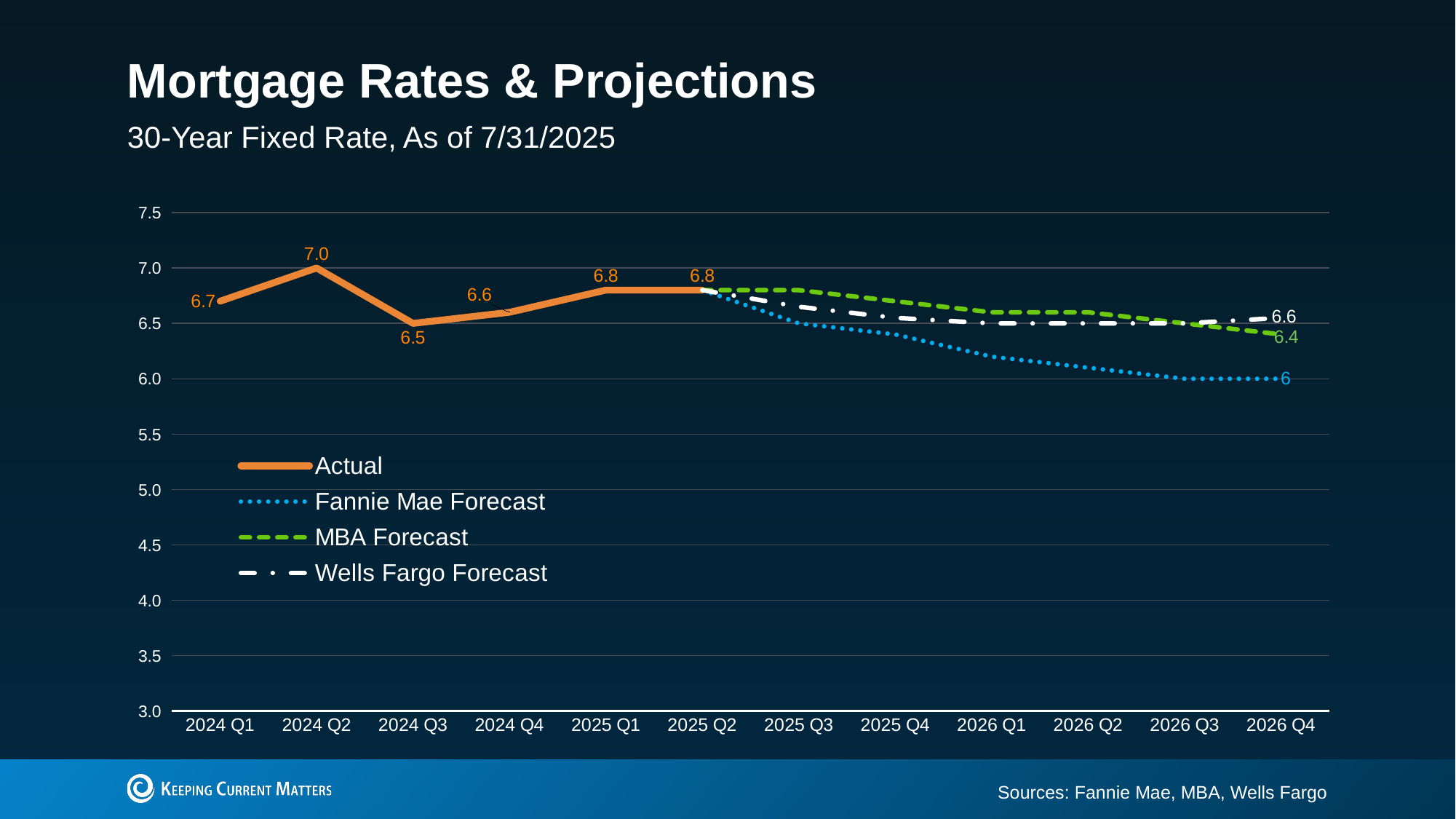
How many series does the legend list? 4 What is the MBA Forecast value for 2026 Q4? 6.4 What kind of chart is shown on the slide? line chart What is the difference between the Actual rate in 2024 Q2 and in 2024 Q3? 0.5 What is the Wells Fargo Forecast value for 2026 Q4? 6.6 How many quarters are shown on the x axis? 12 What is the Actual 30-year fixed rate for 2024 Q3? 6.5 In which quarter is the Actual rate lowest? 2024 Q3 What is the Fannie Mae Forecast value for 2026 Q4? 6 In which quarter is the Actual rate highest? 2024 Q2 What is the Actual 30-year fixed rate for 2024 Q2? 7.0 Which forecast series has the lowest value at 2026 Q4? Fannie Mae Forecast